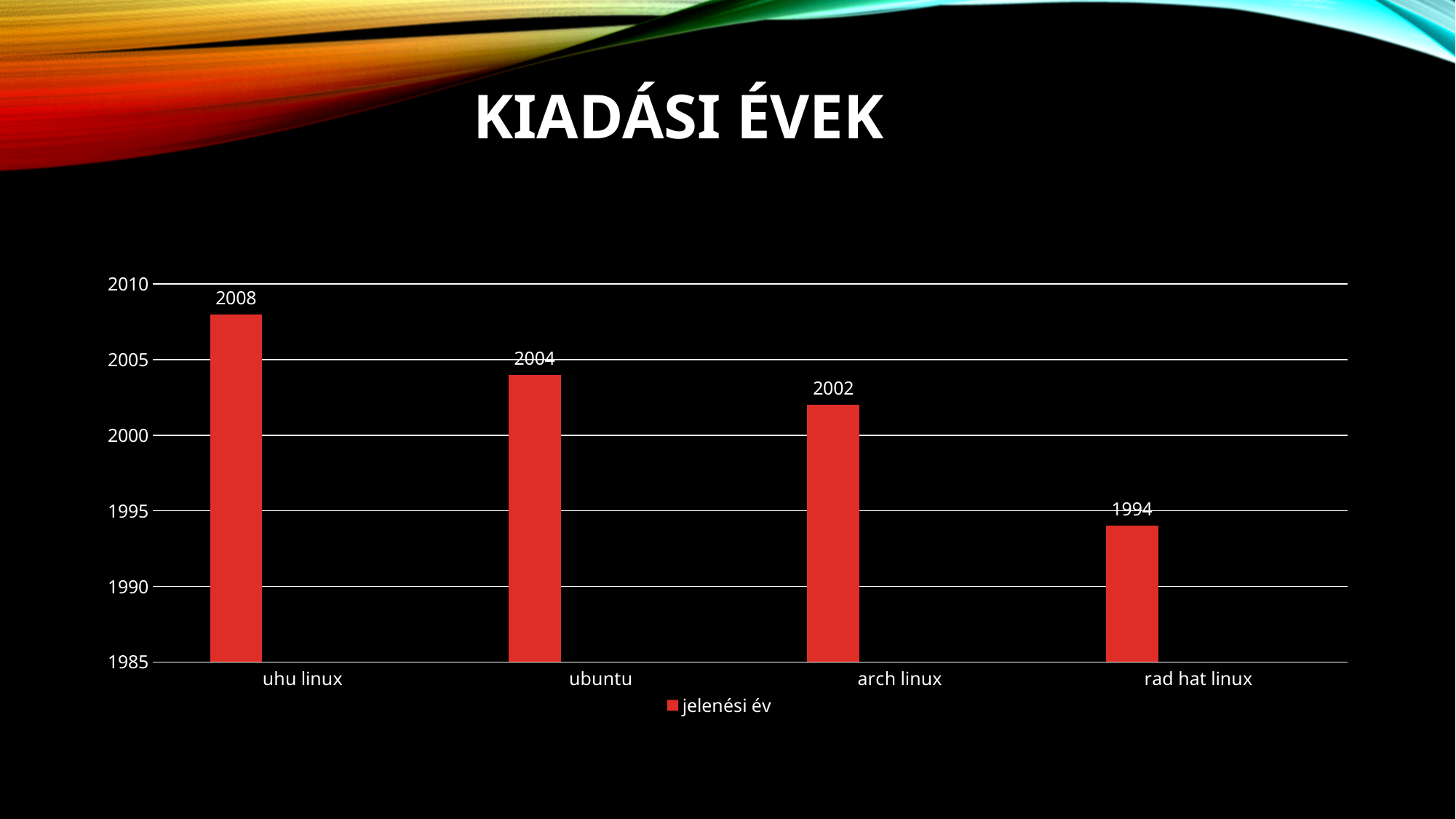
What is the title of the chart? KIADÁSI ÉVEK What is the value for uhu linux? 2008 How many series does the legend list? 1 What kind of chart is shown on the slide? bar chart What is the value for rad hat linux? 1994 Which is larger, the value for ubuntu or the value for arch linux? ubuntu Which category has the lowest value? rad hat linux What is the value for ubuntu? 2004 Which category has the highest value? uhu linux What is the value for arch linux? 2002 What is the difference between the values for uhu linux and rad hat linux? 14 How many categories are shown on the x axis? 4